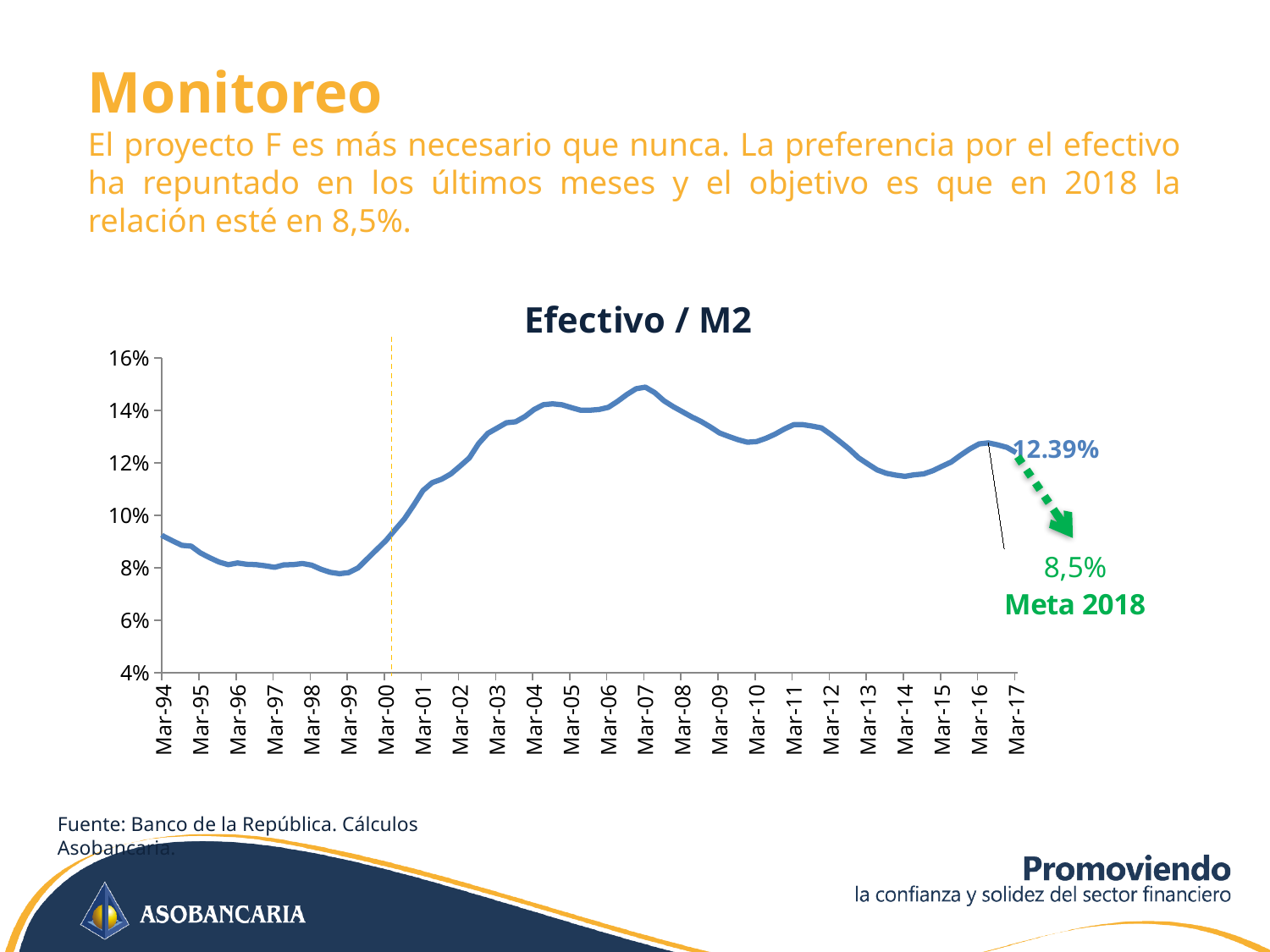
Which is larger, the value at Mar-07 or the value at Mar-17? Mar-07 Around which x-axis label does the line reach its highest point? Mar-07 Is the value at Mar-07 greater or less than 14%? greater Is the value at Mar-03 greater or less than 12%? greater How many x-axis labels are shown on the chart? 24 What is the title of the chart? Efectivo / M2 What value is labelled at the end of the line (Mar-17)? 12.39% What kind of chart is shown on the slide? line chart What is the target value shown for 2018 (Meta 2018)? 8,5% Is the value at Mar-94 greater or less than 10%? less Does the line rise or fall between Mar-99 and Mar-07? rise